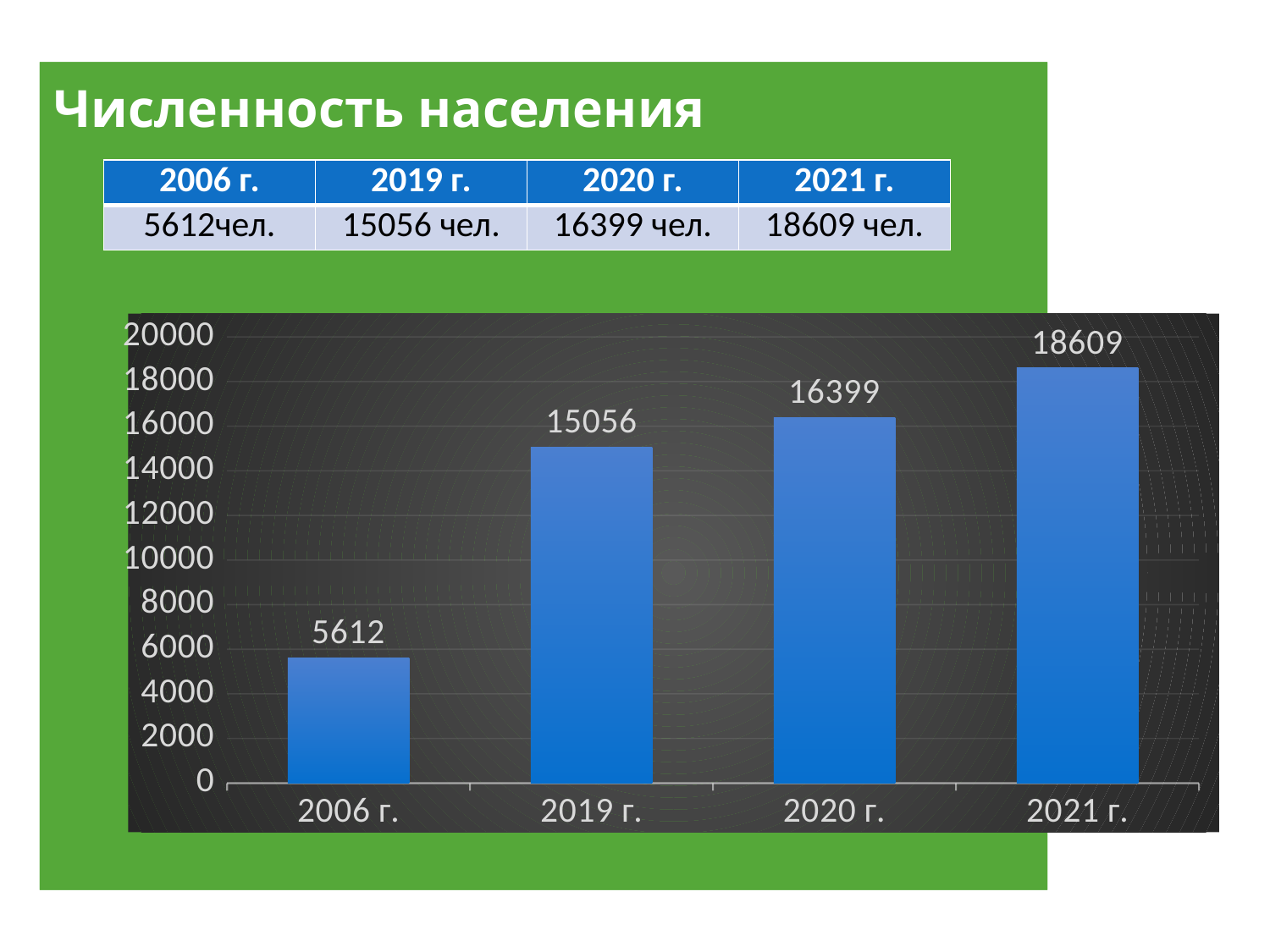
Which year has the highest value? 2021 г. What is the value for 2020 г.? 16399 What is the value for 2021 г.? 18609 What is the value for 2019 г.? 15056 What kind of chart is shown on the slide? bar chart What is the difference between the values for 2019 г. and 2006 г.? 9444 What is the difference between the values for 2021 г. and 2020 г.? 2210 Which is larger, the value for 2019 г. or the value for 2020 г.? 2020 г. Do the values rise or fall from 2006 г. to 2021 г.? rise How many years are shown on the chart? 4 Which year has the lowest value? 2006 г. What is the value for 2006 г.? 5612